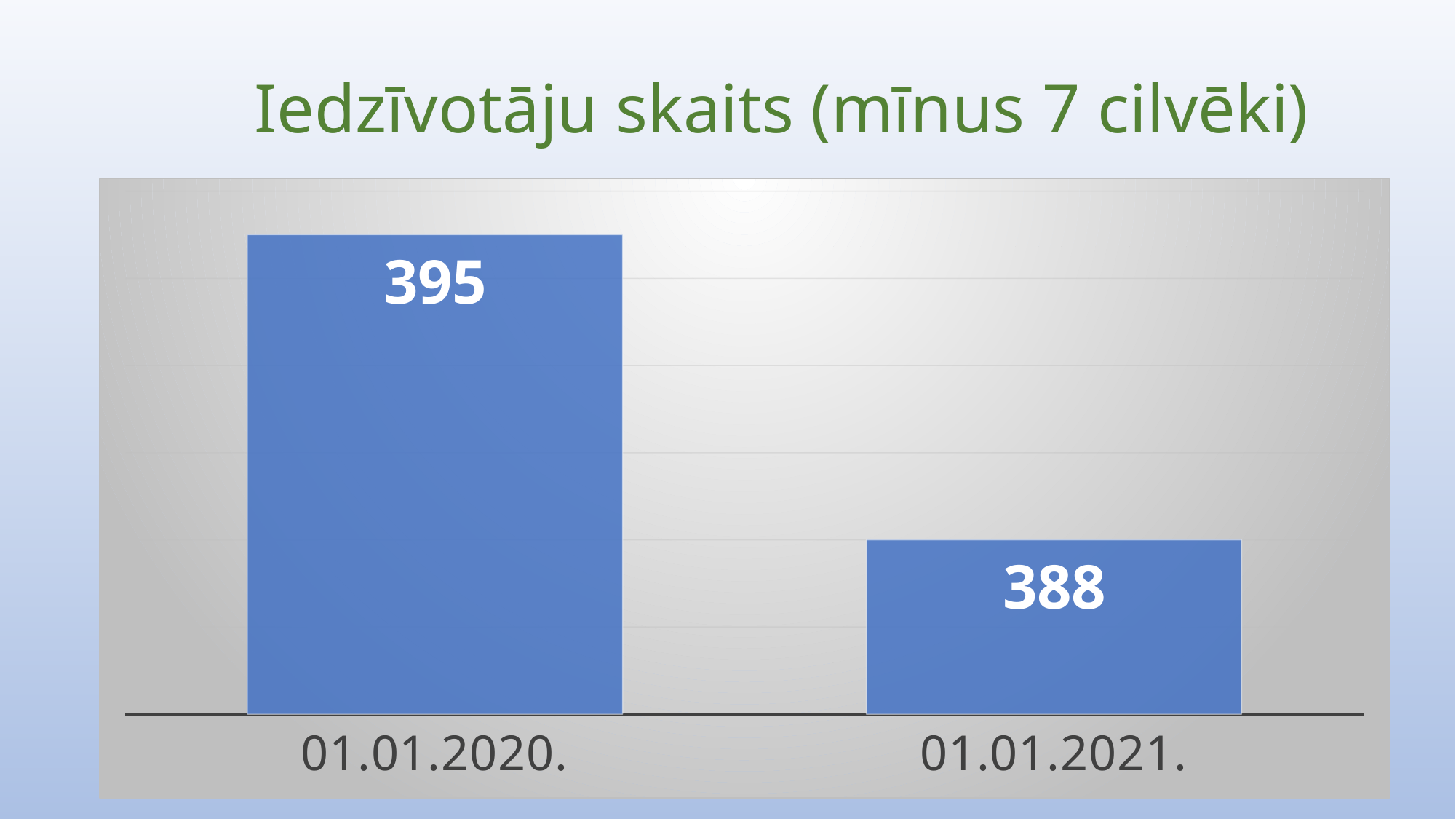
What kind of chart is shown on the slide? bar chart What is the difference between the values for 01.01.2020. and 01.01.2021.? 7 What is the value for 01.01.2020.? 395 Which is larger, the value for 01.01.2020. or the value for 01.01.2021.? 01.01.2020. What is the title of the chart? Iedzīvotāju skaits (mīnus 7 cilvēki) Which category has the highest value? 01.01.2020. Do the values rise or fall from 01.01.2020. to 01.01.2021.? fall Which category has the lowest value? 01.01.2021. How many categories are shown on the chart? 2 What colour are the bars in the chart? blue What is the value for 01.01.2021.? 388